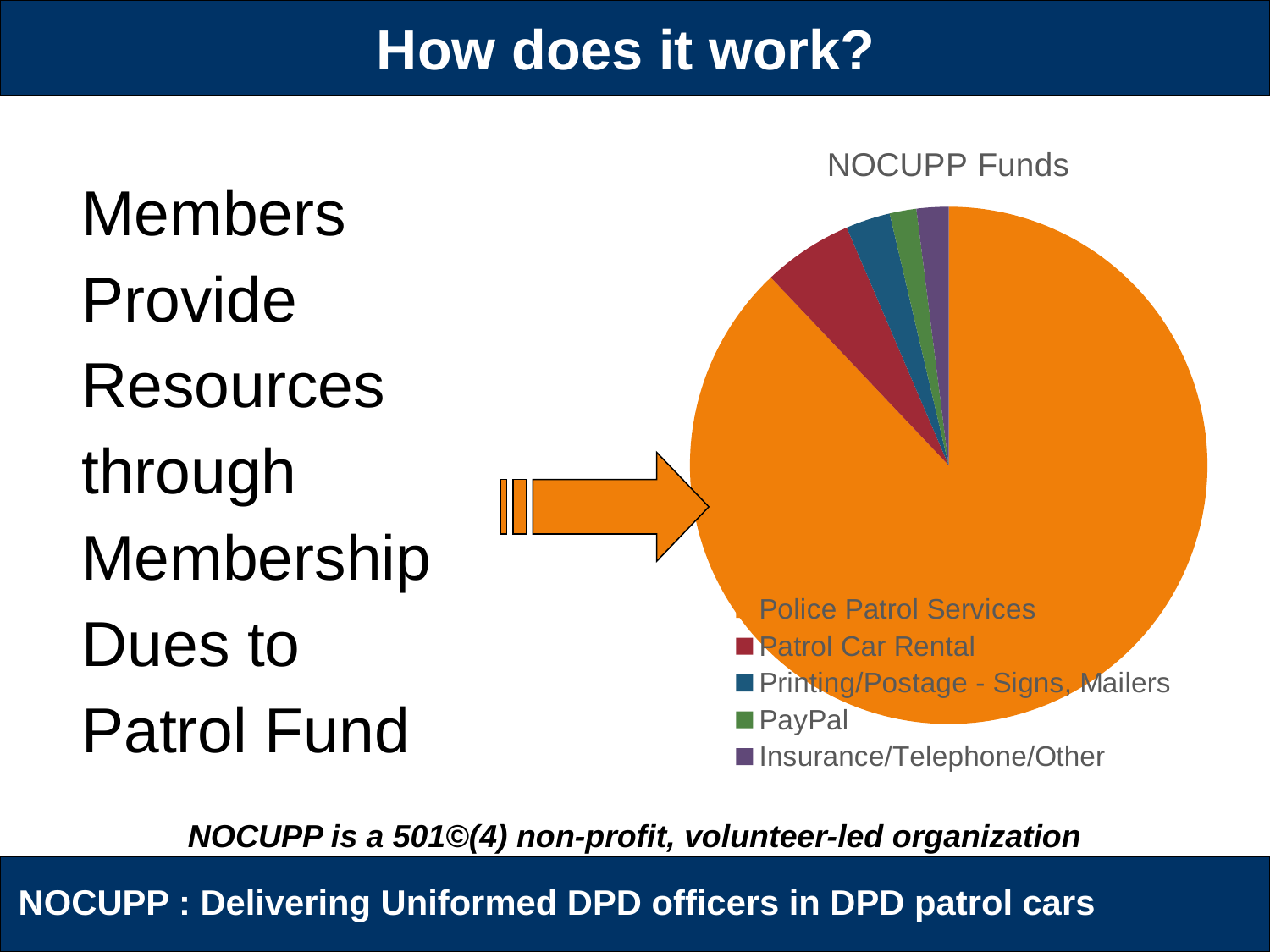
What kind of chart is shown on the slide? pie chart How many entries does the legend of the NOCUPP Funds chart list? 5 Which is larger in the NOCUPP Funds pie chart, Police Patrol Services or Patrol Car Rental? Police Patrol Services Which is larger in the NOCUPP Funds pie chart, Patrol Car Rental or PayPal? Patrol Car Rental How many categories does the NOCUPP Funds pie chart have? 5 Which is larger in the NOCUPP Funds pie chart, Patrol Car Rental or Printing/Postage - Signs, Mailers? Patrol Car Rental Which category is the second largest slice in the NOCUPP Funds pie chart? Patrol Car Rental What is the title of the chart? NOCUPP Funds Which category takes the largest share of the NOCUPP Funds pie chart? Police Patrol Services What colour is the Police Patrol Services slice in the NOCUPP Funds pie chart? orange